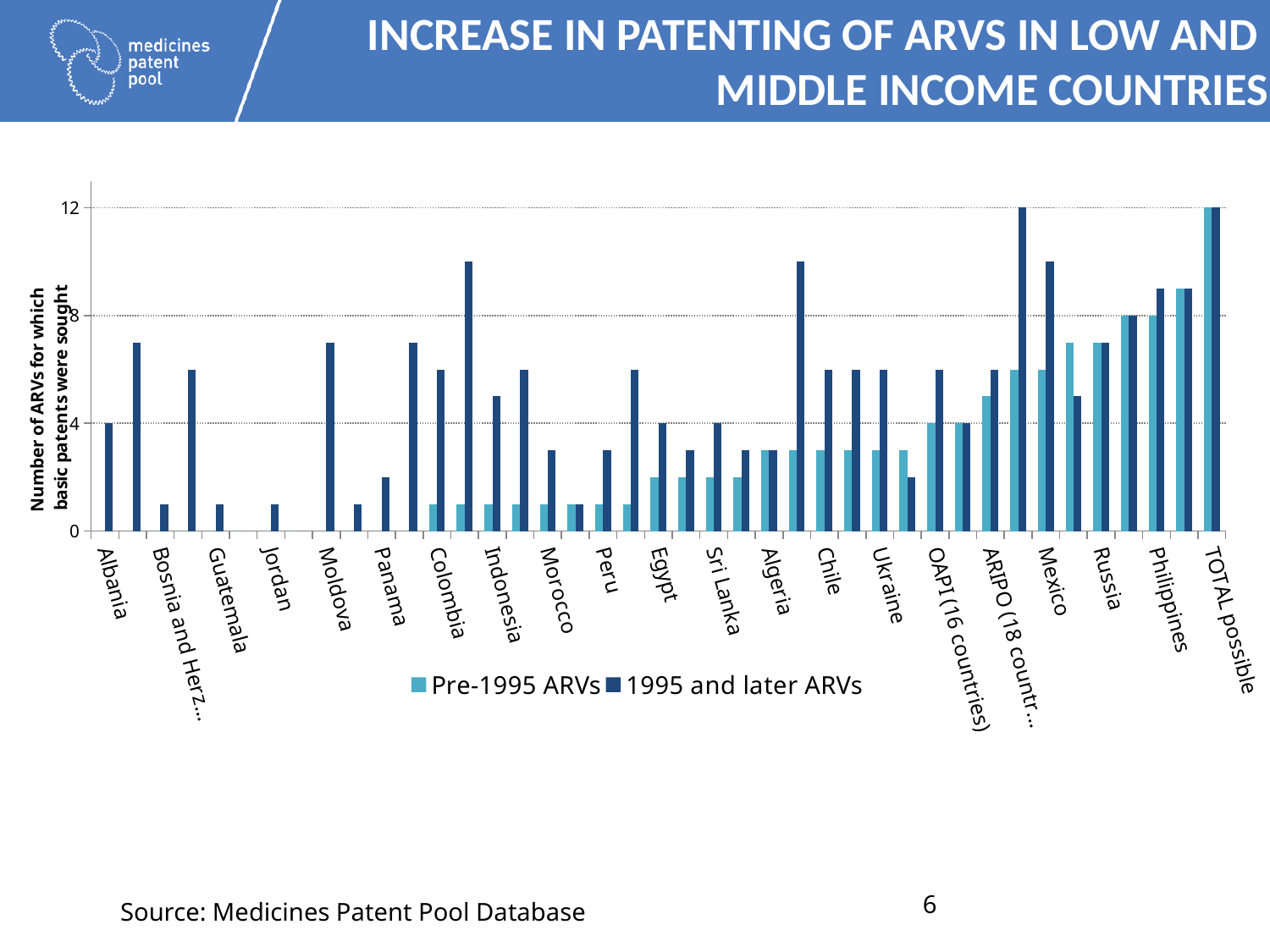
What is the value for TOTAL possible in the 1995 and later ARVs series? 12 What kind of chart is shown on the slide? bar chart What are the two series named in the legend? Pre-1995 ARVs and 1995 and later ARVs Is the value for Moldova in the 1995 and later ARVs series greater or less than 4? greater How many series does the legend list? 2 For Mexico, which series has the larger value, Pre-1995 ARVs or 1995 and later ARVs? 1995 and later ARVs What is the label on the vertical axis? Number of ARVs for which basic patents were sought What is the value for Albania in the 1995 and later ARVs series? 4 What is the value for Egypt in the 1995 and later ARVs series? 4 Do the Pre-1995 ARVs values generally rise or fall from left to right along the x axis? rise What is the value for Philippines in the Pre-1995 ARVs series? 8 Is the value for Mexico in the 1995 and later ARVs series greater or less than 8? greater